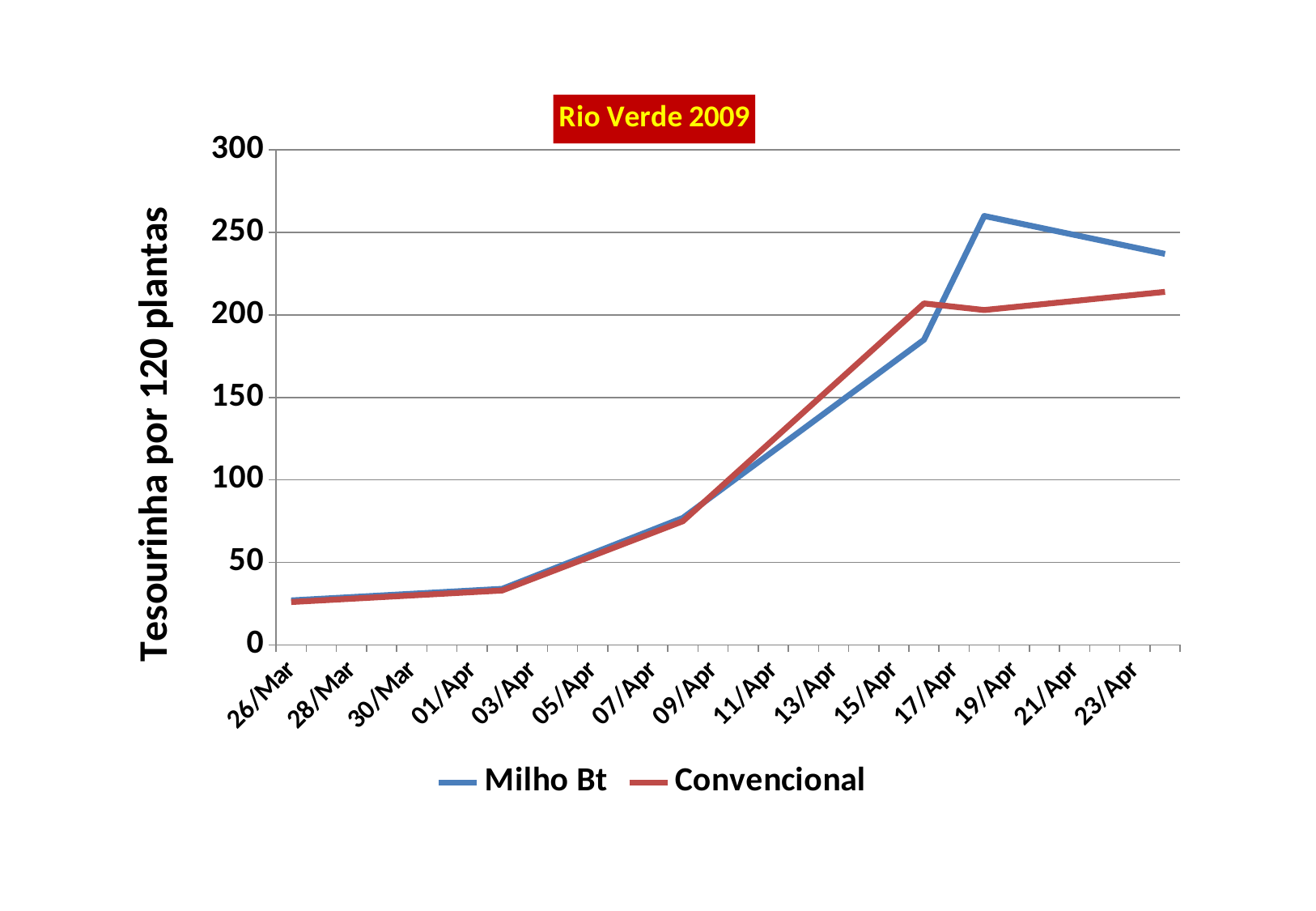
Is the value for Milho Bt on 19/Apr greater or less than 250? greater Is the value for Milho Bt on 17/Apr greater or less than 200? less Is the value for Milho Bt on 26/Mar greater or less than 50? less On 19/Apr, which series has the higher value, Milho Bt or Convencional? Milho Bt On which date does the Milho Bt series reach its highest value? 19/Apr What is the title of the chart? Rio Verde 2009 What is the label of the vertical axis? Tesourinha por 120 plantas What kind of chart is shown on the slide? line chart How many series does the legend list? 2 On 17/Apr, which series has the higher value, Milho Bt or Convencional? Convencional